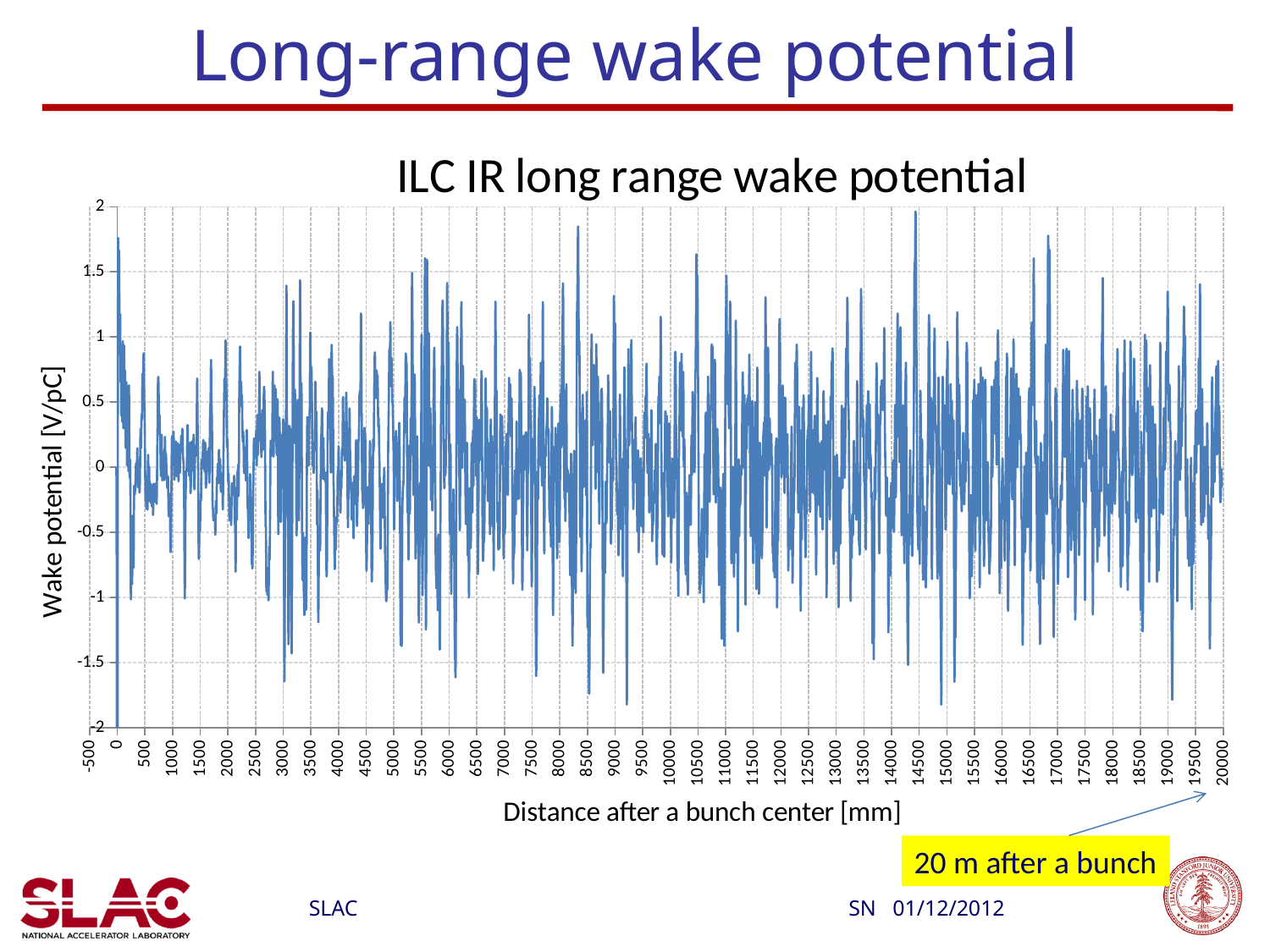
What is the label of the y axis of the chart? Wake potential [V/pC] Along the x axis, does the wake potential steadily rise, steadily fall, or oscillate around zero? oscillate around zero Is the peak of the wake potential near 14500 mm greater or less than 1.5? greater Is the lowest value of the wake potential greater or less than -1.5? less Is the highest peak of the wake potential greater or less than 1.5? greater What kind of chart is shown on the slide? Line chart How many data series are plotted in the chart? 1 What is the title of the chart? ILC IR long range wake potential